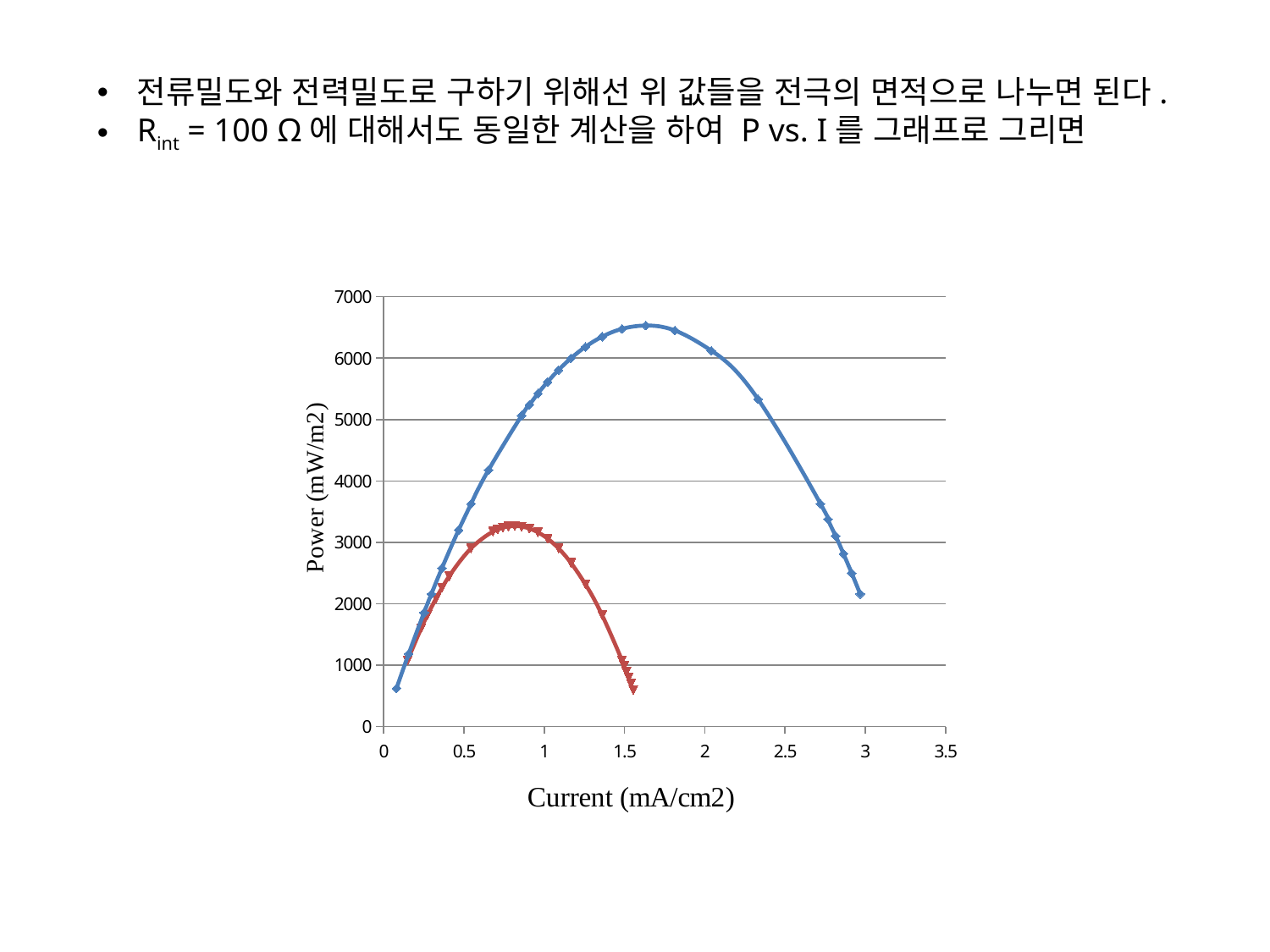
Is the value of the blue curve at a current of 1 mA/cm2 greater or less than 5000? greater Is the peak value of the blue curve greater or less than 6000? greater What kind of chart is shown on the slide? line chart What is the title of the y axis of the chart? Power (mW/m2) Which curve reaches a higher maximum power, the blue one or the red one? the blue one Is the peak value of the red curve greater or less than 3000? greater Does the red curve rise or fall as current increases from 0 to 0.5 mA/cm2? rise Does the blue curve rise or fall as current increases from 2 to 3 mA/cm2? fall What is the title of the x axis of the chart? Current (mA/cm2)